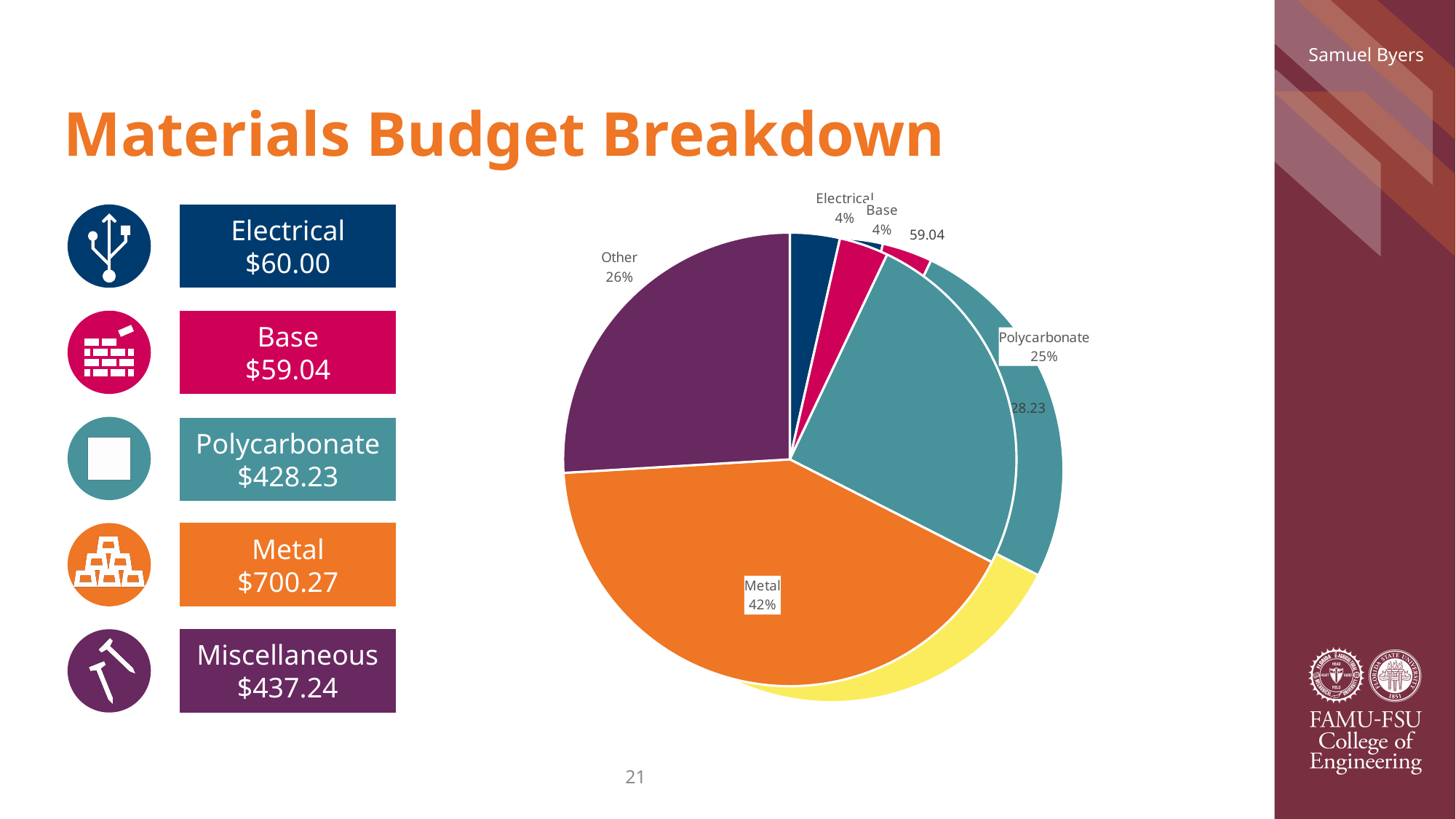
What share of the pie chart does Metal represent? 42% What share of the pie chart does Polycarbonate represent? 25% What kind of chart is shown on the slide? Pie chart Which category has the largest slice in the pie chart, Metal or Other? Metal What share of the pie chart does Base represent? 4% What colour is the Metal slice in the pie chart? Orange What is the difference in percentage share between Metal and Other in the pie chart? 16% How many categories are shown in the pie chart? 5 Which category has the largest slice in the pie chart? Metal Which category has the larger slice in the pie chart, Polycarbonate or Metal? Metal